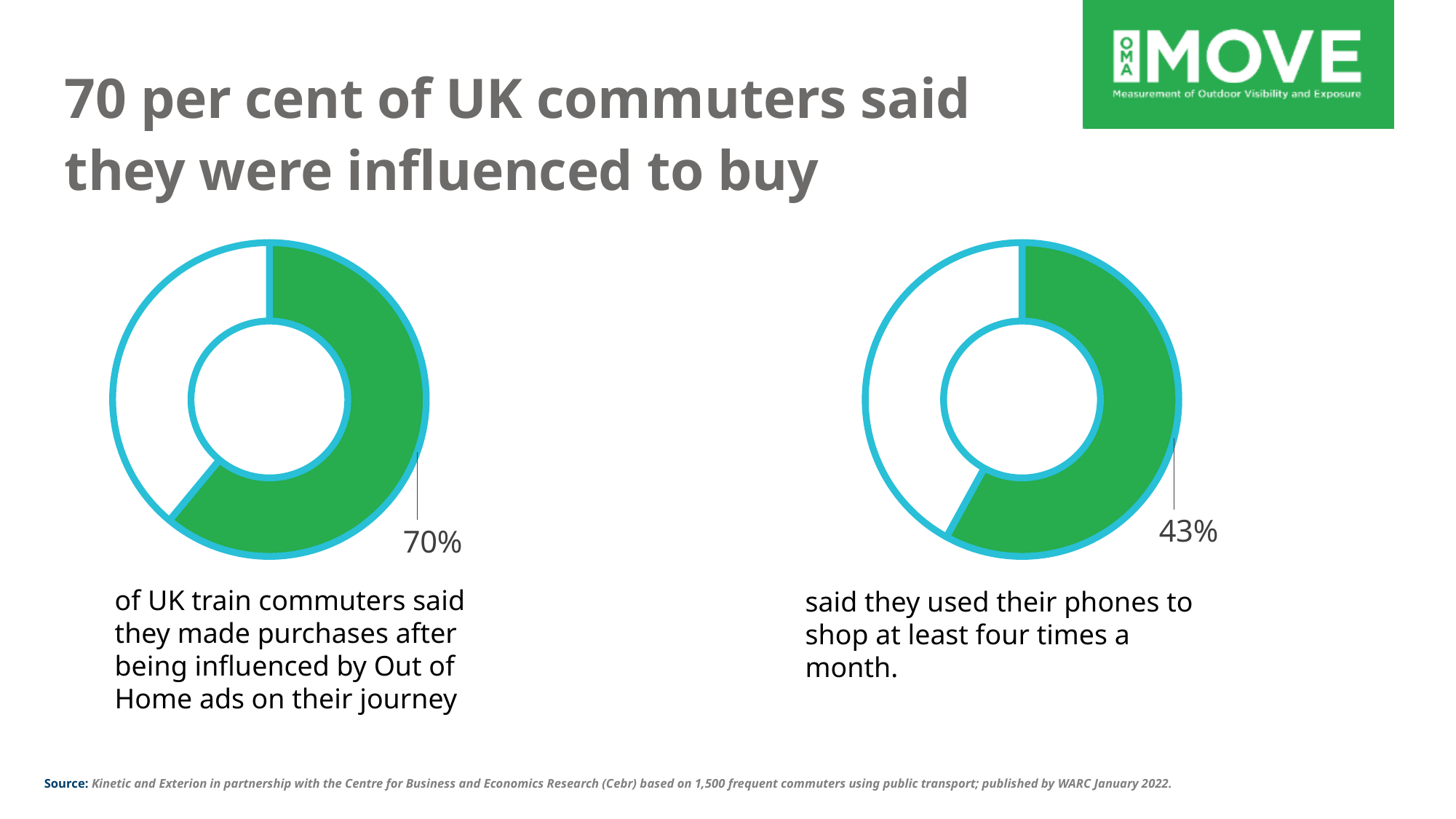
How many donut charts are shown on the slide? 2 On the left donut chart, is the highlighted value greater or less than 50%? greater Which chart shows the larger highlighted share, the left chart or the right chart? The left chart What colour is used for the highlighted segment in both donut charts? Green What kind of chart is used on the left of the slide? Donut (pie) chart On the left donut chart, what percentage of UK train commuters said they made purchases after being influenced by Out of Home ads on their journey? 70% What is the difference in percentage points between the value on the left chart (70%) and the value on the right chart (43%)? 27 percentage points On the right donut chart, what percentage said they used their phones to shop at least four times a month? 43% What is the title of the slide? 70 per cent of UK commuters said they were influenced to buy